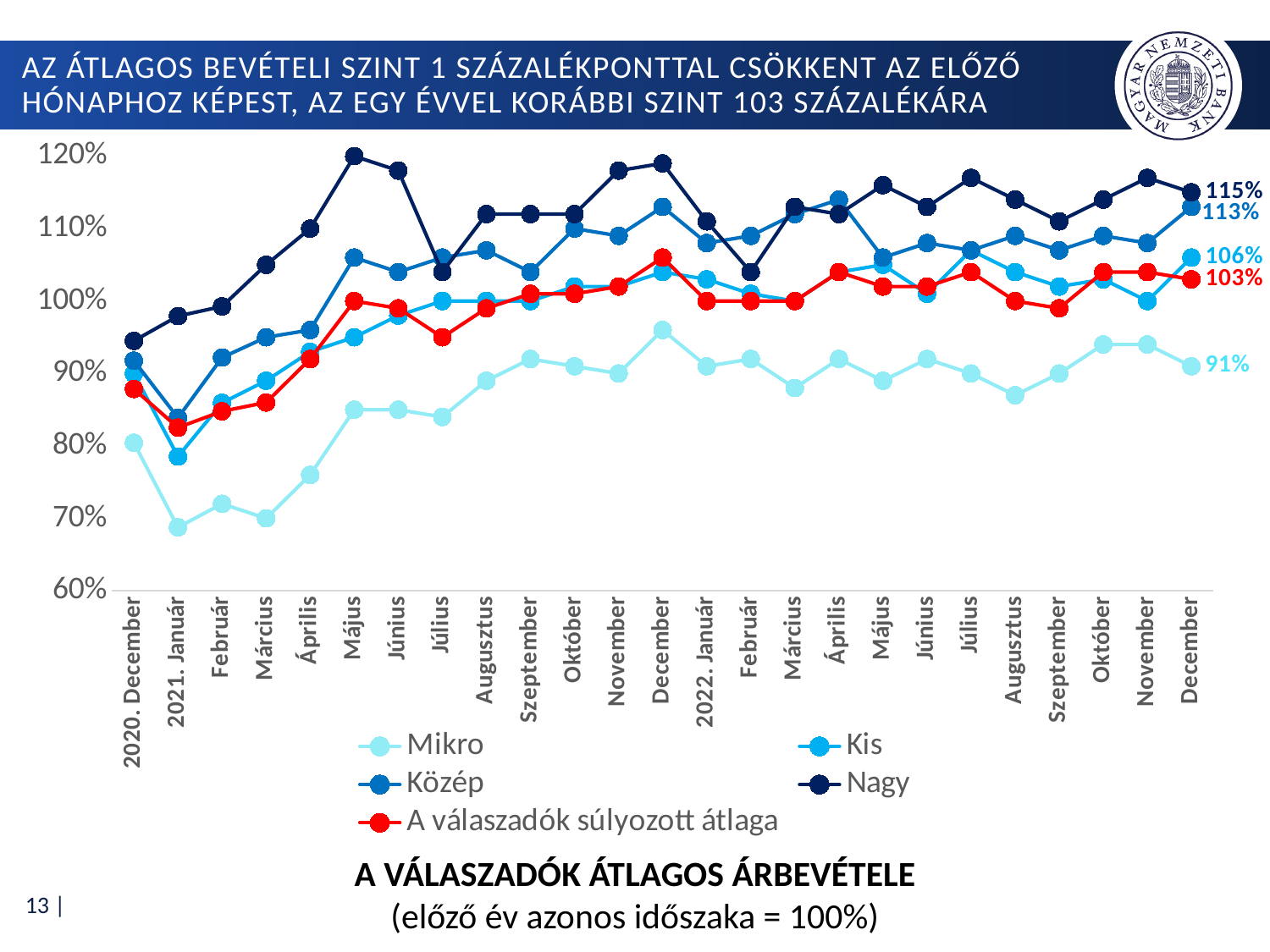
Is the value for Mikro in 2021 Január greater or less than 70%? less How many months are shown on the x axis? 25 Which series has the highest value in 2022 December? Nagy What is the value of the Nagy series in 2022 December? 115% Is the value for Nagy in 2021 Május greater or less than 110%? greater Which series is drawn in red? A válaszadók súlyozott átlaga What type of chart is shown on the slide? line chart How many series does the legend list? 5 What is the difference between the Közép and Kis values in 2022 December? 7 percentage points Which series has the lowest value in 2022 December? Mikro What is the value of the Mikro series in 2022 December? 91% What is the value of 'A válaszadók súlyozott átlaga' in 2022 December? 103%